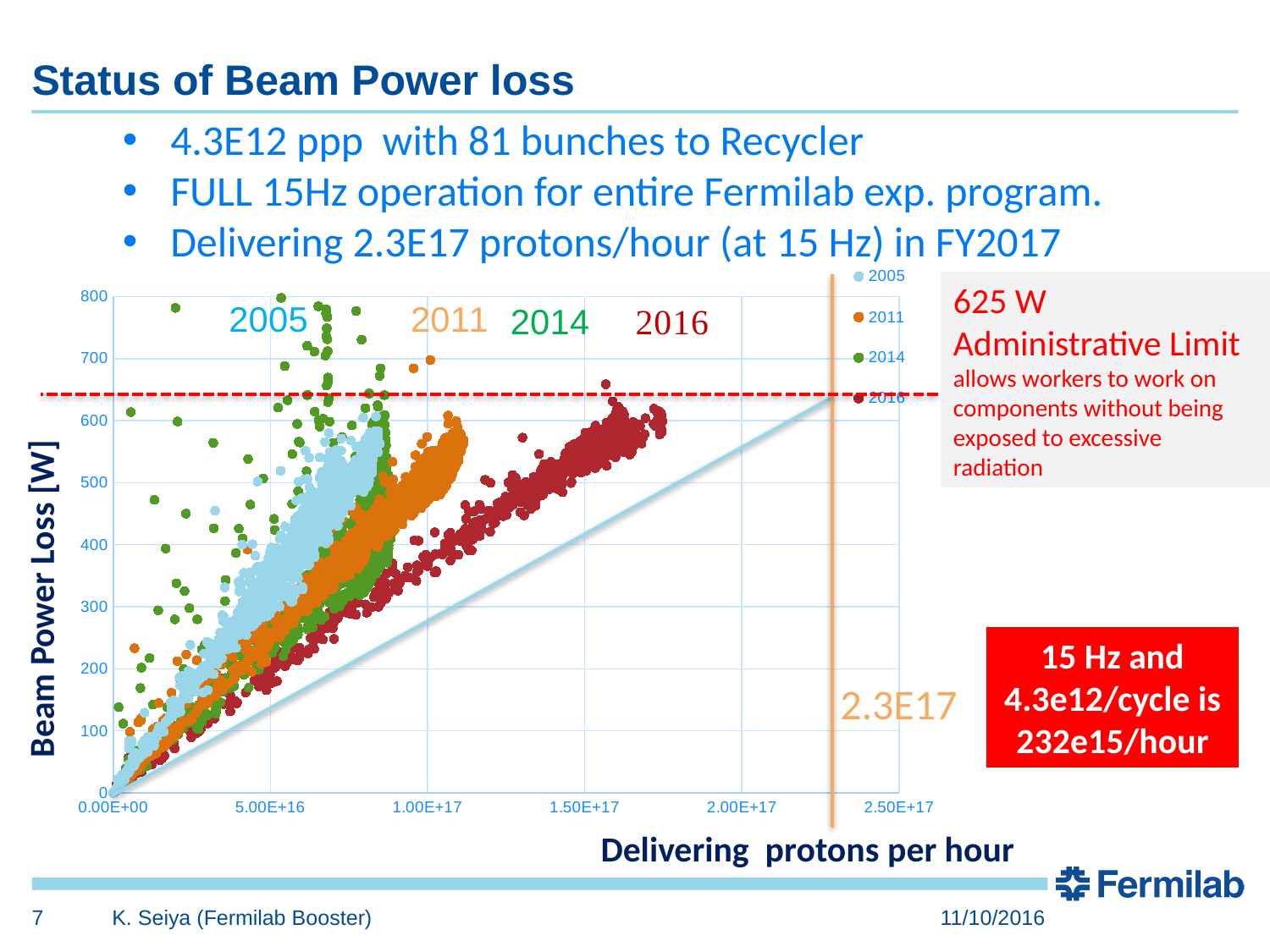
Is the highest beam power loss value reached by the 2016 series greater or less than 500? greater Does beam power loss rise or fall as delivered protons per hour increases? rise Is the highest beam power loss value reached by the 2016 series greater or less than 700? less Which series reaches the highest beam power loss values on the chart? 2014 Which years are listed as series in the chart legend? 2005, 2011, 2014, 2016 What is the label of the vertical axis of the chart? Beam Power Loss [W] What is the highest tick value shown on the vertical axis? 800 How many series does the chart legend list? 4 At the same delivered protons per hour, which series shows a larger beam power loss, 2005 or 2016? 2005 What kind of chart is shown on the slide? scatter chart Which series extends furthest to the right along the x axis (highest protons per hour)? 2016